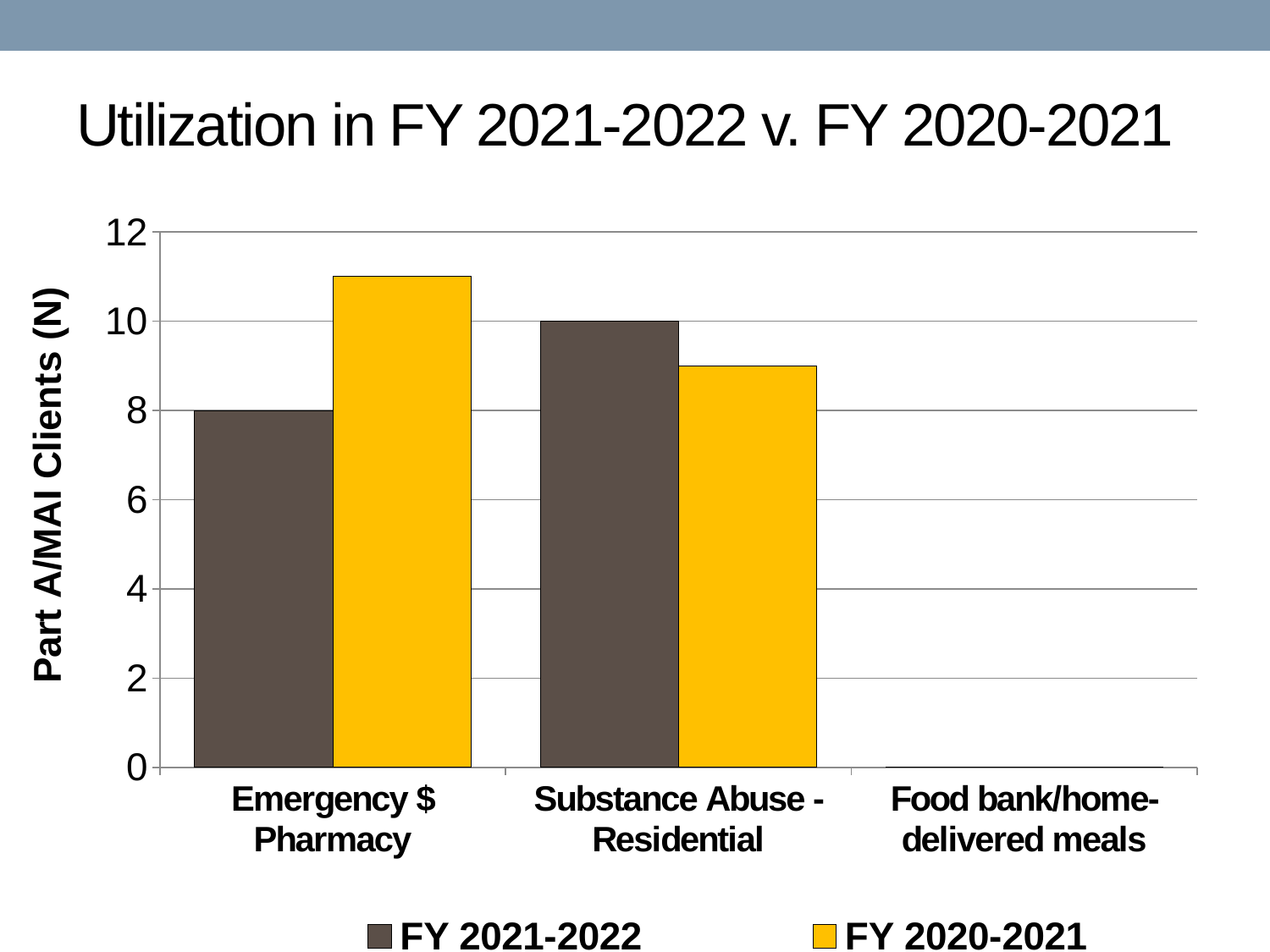
What is the value for Emergency $ Pharmacy in FY 2021-2022? 8 What is the value for Substance Abuse - Residential in FY 2021-2022? 10 How many series does the legend list? 2 What type of chart is shown on the slide? Bar chart Is the FY 2020-2021 value for Emergency $ Pharmacy greater or less than 10? greater What is the label of the y axis? Part A/MAI Clients (N) What is the value for Food bank/home-delivered meals in FY 2021-2022? 0 For Emergency $ Pharmacy, which fiscal year has the larger value? FY 2020-2021 How many categories are shown on the x axis? 3 Is the FY 2020-2021 value for Substance Abuse - Residential greater or less than 10? less In FY 2021-2022, what is the difference between the Substance Abuse - Residential value and the Emergency $ Pharmacy value? 2 For Substance Abuse - Residential, which fiscal year has the larger value? FY 2021-2022